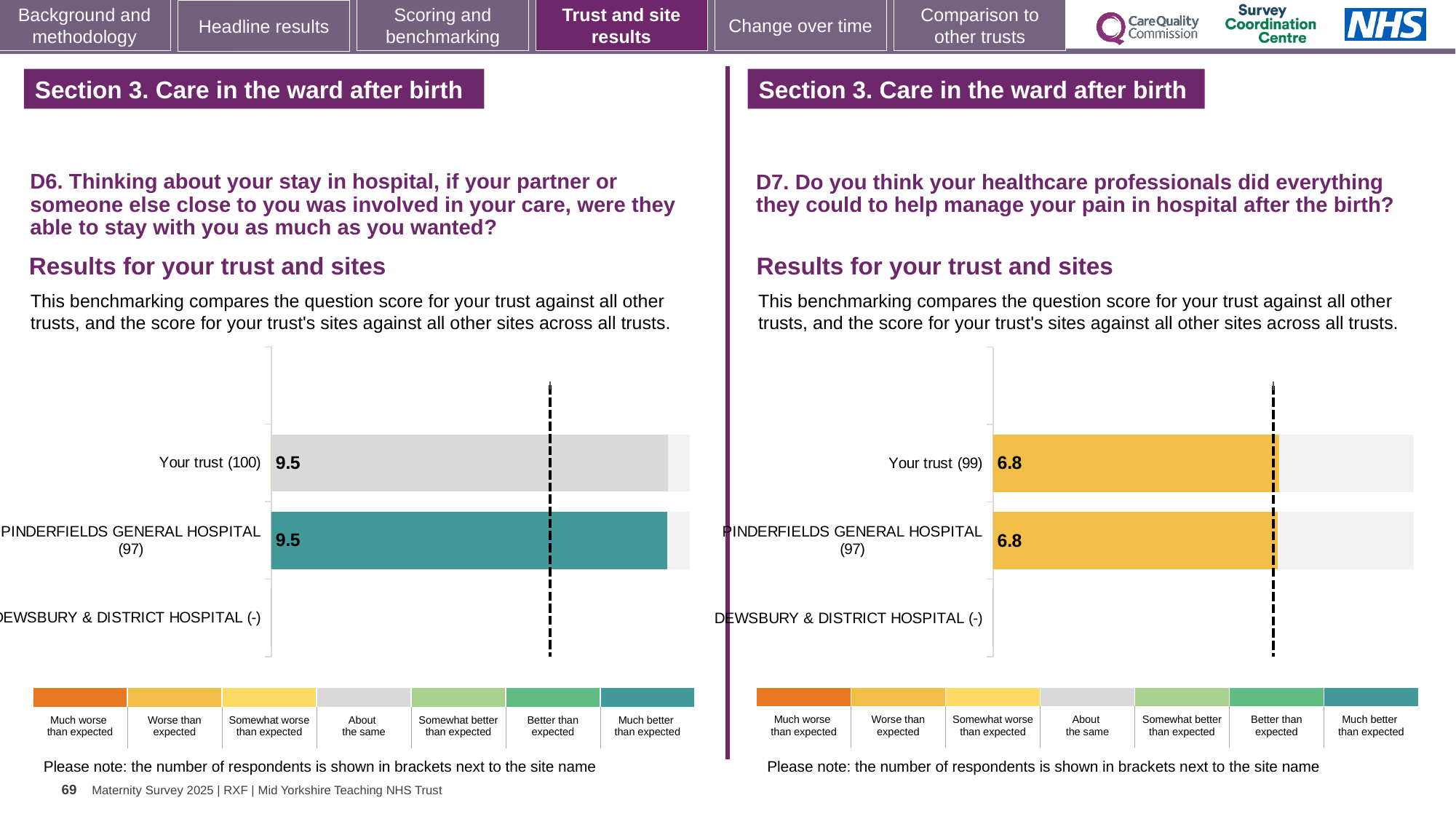
What kind of chart is the left chart (D6)? Bar chart On the left chart (D6), what is the score for Pinderfields General Hospital? 9.5 How many categories are listed on the right chart (D7)? 3 On the right chart (D7), what is the score for Pinderfields General Hospital? 6.8 On the right chart (D7), what is the score for Your trust? 6.8 On the left chart (D6), what is the difference between the score for Your trust and the score for Pinderfields General Hospital? 0 Is the score for Your trust on the left chart (D6) larger or smaller than the score for Your trust on the right chart (D7)? Larger How many categories are listed on the left chart (D6)? 3 On the right chart (D7), how many respondents are shown in brackets for Your trust? 99 On the left chart (D6), what is the score for Your trust? 9.5 On the right chart (D7), what is the difference between the score for Your trust and the score for Pinderfields General Hospital? 0 On the left chart (D6), how many respondents are shown in brackets for Your trust? 100